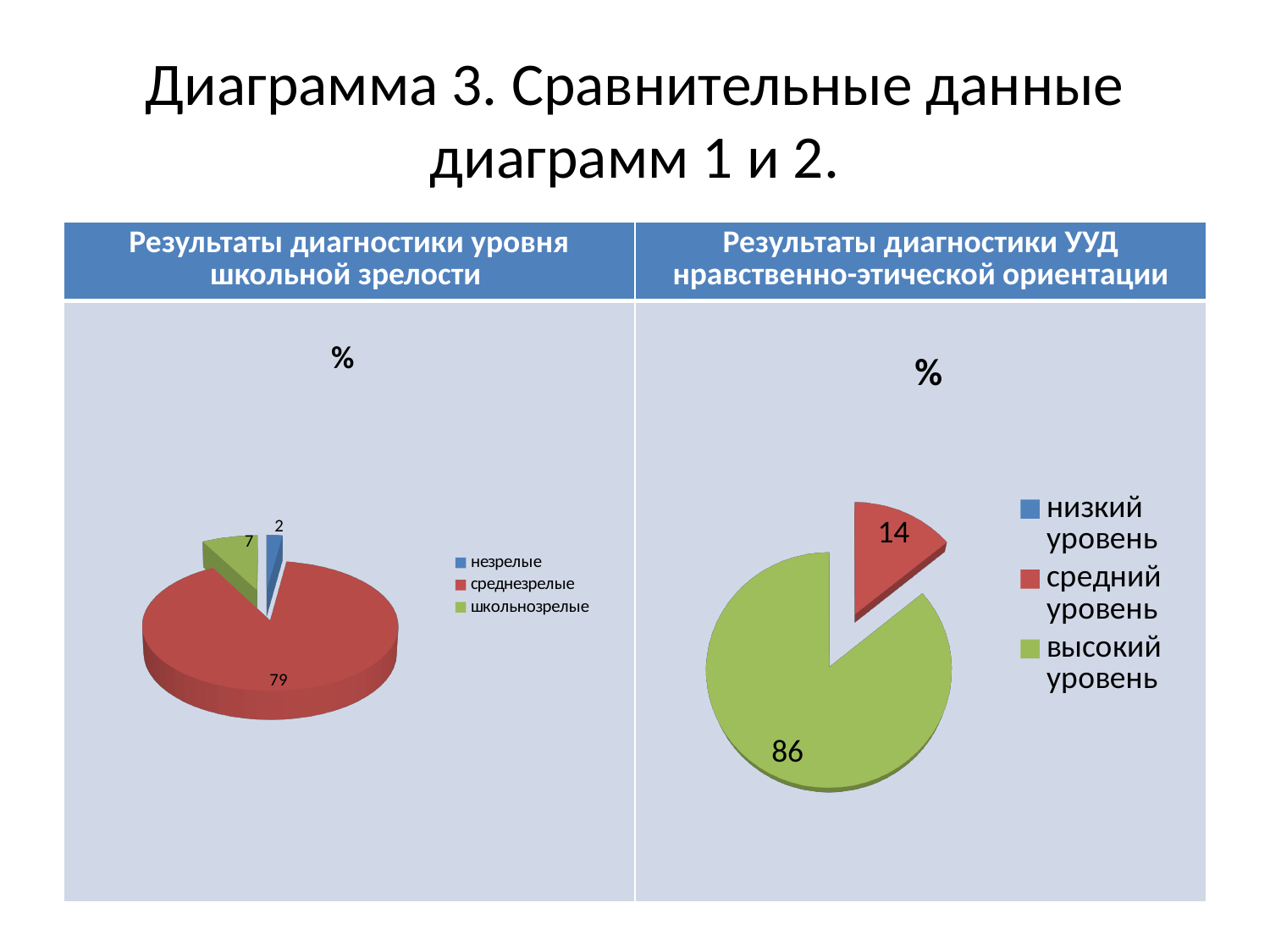
How many entries does the legend of the right chart (Результаты диагностики УУД нравственно-этической ориентации) list? 3 In the left chart (Результаты диагностики уровня школьной зрелости), which category has the smallest slice? незрелые In the right chart (Результаты диагностики УУД нравственно-этической ориентации), what is the value for средний уровень? 14 In the left chart (Результаты диагностики уровня школьной зрелости), what is the value for незрелые? 2 In the left chart (Результаты диагностики уровня школьной зрелости), which category has the largest slice? среднезрелые In the left chart (Результаты диагностики уровня школьной зрелости), what is the value for среднезрелые? 79 In the left chart (Результаты диагностики уровня школьной зрелости), what is the value for школьнозрелые? 7 What type of chart is the right chart (Результаты диагностики УУД нравственно-этической ориентации)? pie chart In the left chart (Результаты диагностики уровня школьной зрелости), which is larger: школьнозрелые or незрелые? школьнозрелые In the right chart (Результаты диагностики УУД нравственно-этической ориентации), what is the value for высокий уровень? 86 In the right chart (Результаты диагностики УУД нравственно-этической ориентации), what is the difference between высокий уровень and средний уровень? 72 In the left chart (Результаты диагностики уровня школьной зрелости), what colour is the среднезрелые slice? red